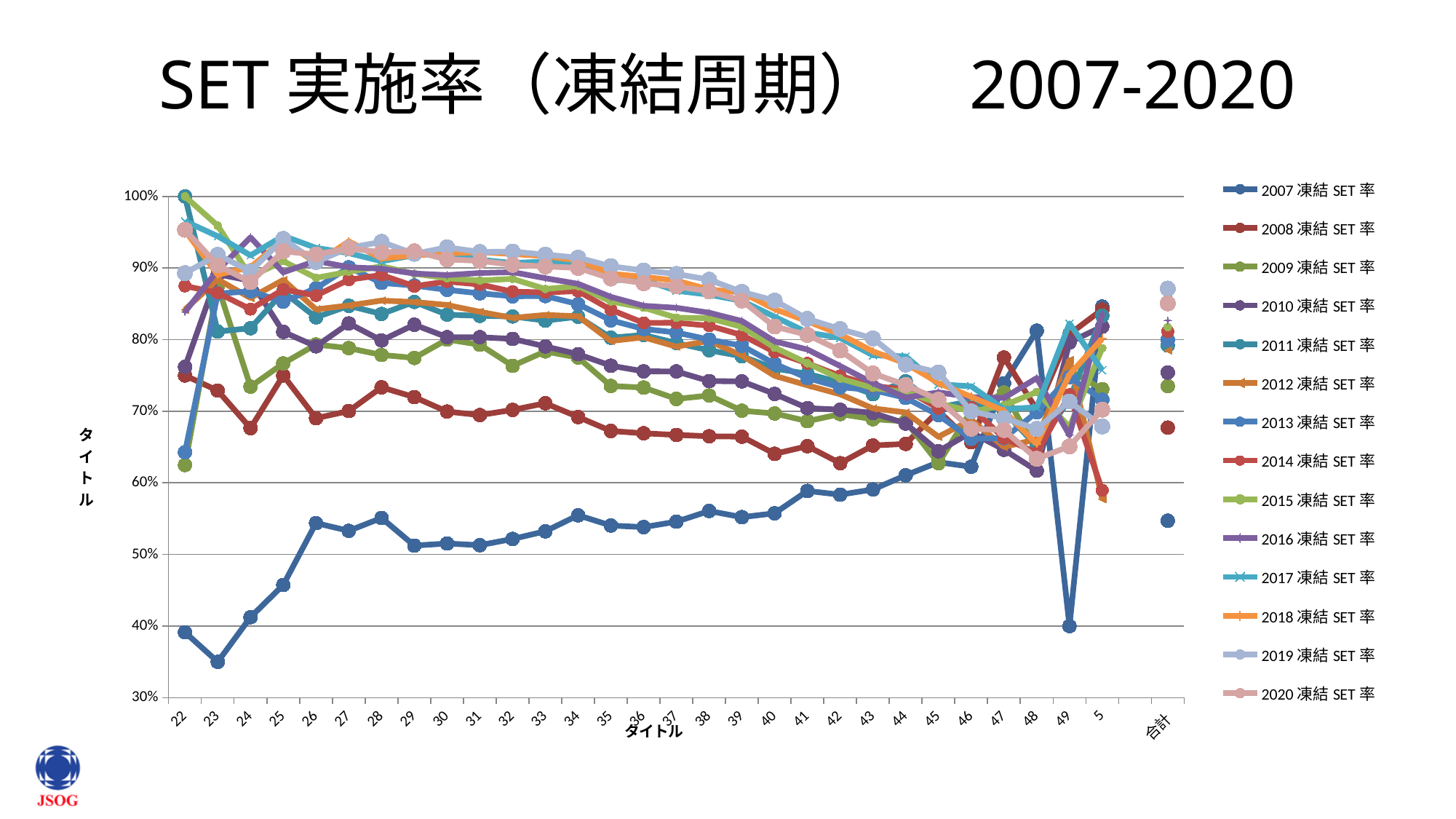
What is the first entry in the legend? 2007 凍結 SET 率 At category 22, which is larger: the value for 2007 凍結 SET 率 or 2008 凍結 SET 率? 2008 凍結 SET 率 Is the value for 2019 凍結 SET 率 at category 28 greater or less than 90%? greater Is the value for 2008 凍結 SET 率 at category 36 greater or less than 70%? less Is the value for 2007 凍結 SET 率 at category 23 greater or less than 40%? less How many series does the legend list? 14 Does the 2019 凍結 SET 率 series generally rise or fall from category 28 to category 49? fall What kind of chart is shown on the slide? line chart Which series has the lowest value at the 合計 category? 2007 凍結 SET 率 Which series has the lowest value at category 30? 2007 凍結 SET 率 What is the title of the slide? SET 実施率（凍結周期） 2007-2020